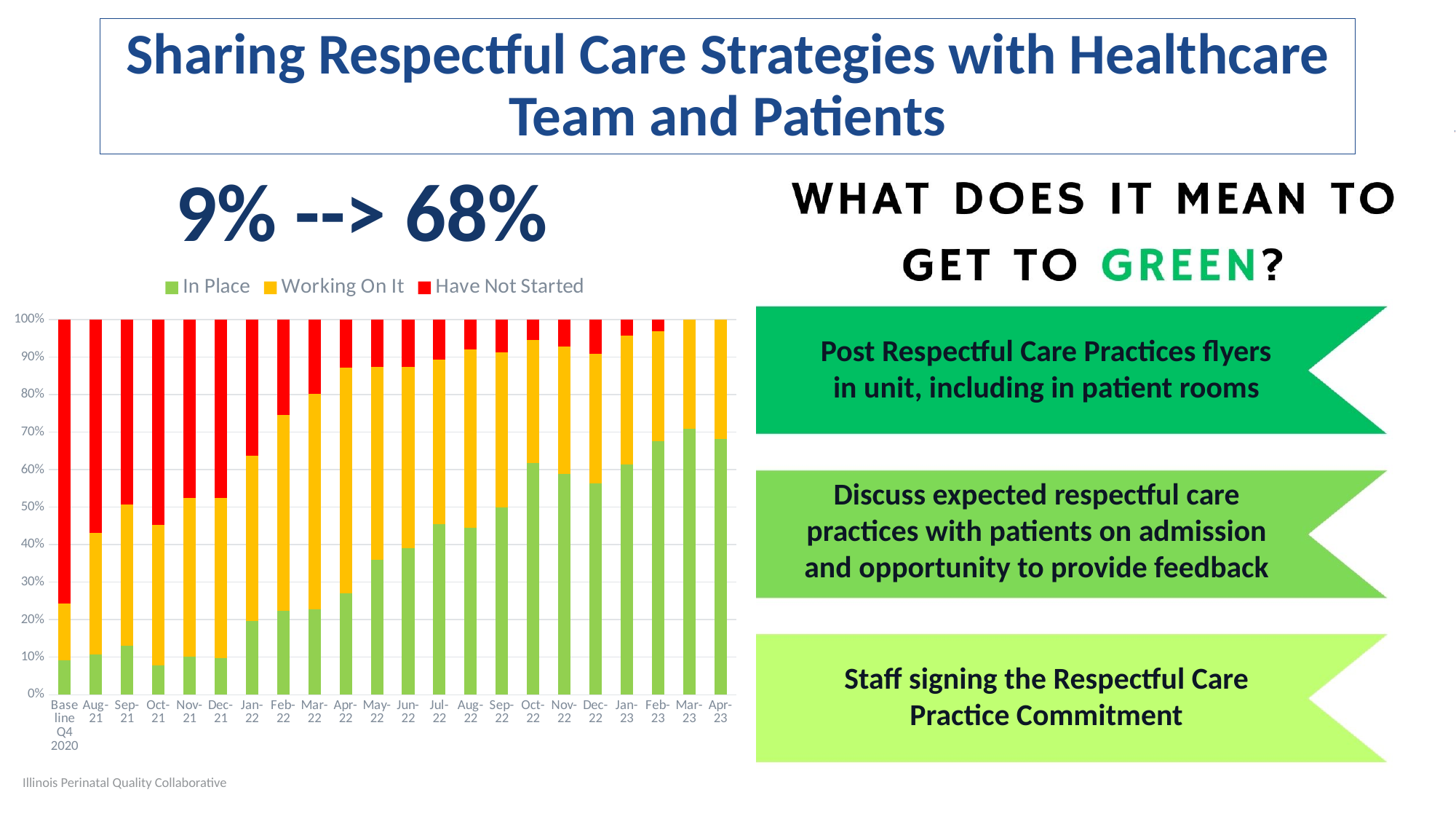
Does the 'Have Not Started' share generally rise or fall across the months shown? Fall How many series does the chart legend list? 3 Which colour represents the 'In Place' series in the chart? Green Which series is shown in red in the chart? Have Not Started What is the total height of each stacked bar in the chart? 100% Is the 'In Place' value for Mar-23 greater or less than 60%? greater According to the headline text above the chart, what did the 'In Place' percentage change from and to? 9% to 68% How many time periods (bars) are plotted on the x axis of the chart? 22 What kind of chart is shown on the slide? Stacked bar chart Which has a larger 'In Place' value, Jan-22 or Jul-22? Jul-22 Does the 'In Place' share generally rise or fall from Baseline Q4 2020 to Apr-23? Rise Is the 'In Place' value for Baseline Q4 2020 greater or less than 20%? less